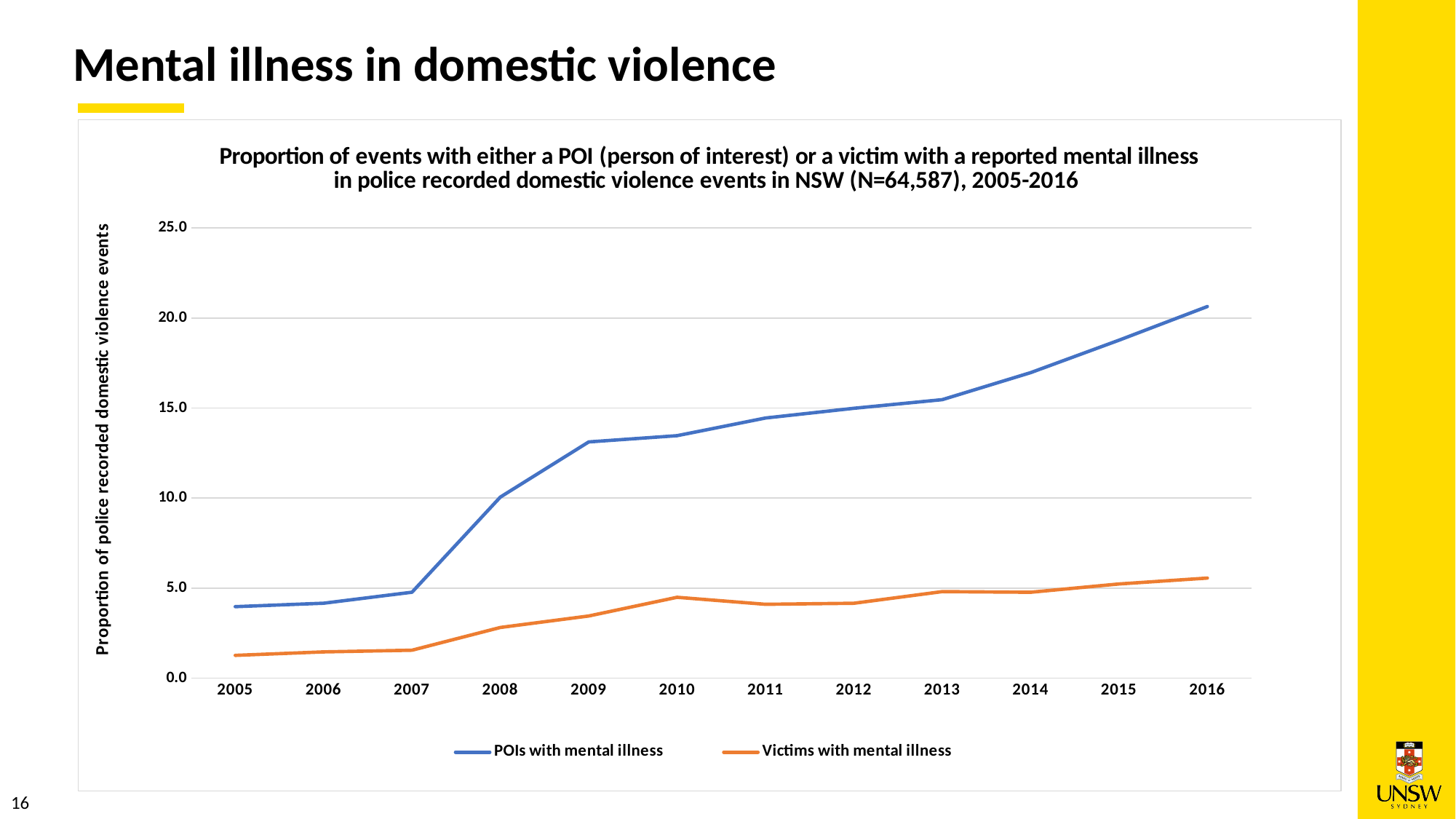
In which year is the value for POIs with mental illness highest? 2016 Is the value for Victims with mental illness in 2010 greater or less than 5.0? less How many years are plotted along the x axis? 12 In which year is the value for POIs with mental illness lowest? 2005 What is the y-axis title of the chart? Proportion of police recorded domestic violence events Does the value for POIs with mental illness rise or fall from 2005 to 2016? Rise In 2016, which series has the larger value: POIs with mental illness or Victims with mental illness? POIs with mental illness What kind of chart is shown on the slide? Line chart Is the value for POIs with mental illness in 2009 greater or less than 15.0? less Is the value for POIs with mental illness in 2016 greater or less than 20.0? greater In which year is the value for Victims with mental illness highest? 2016 How many series does the legend list? 2